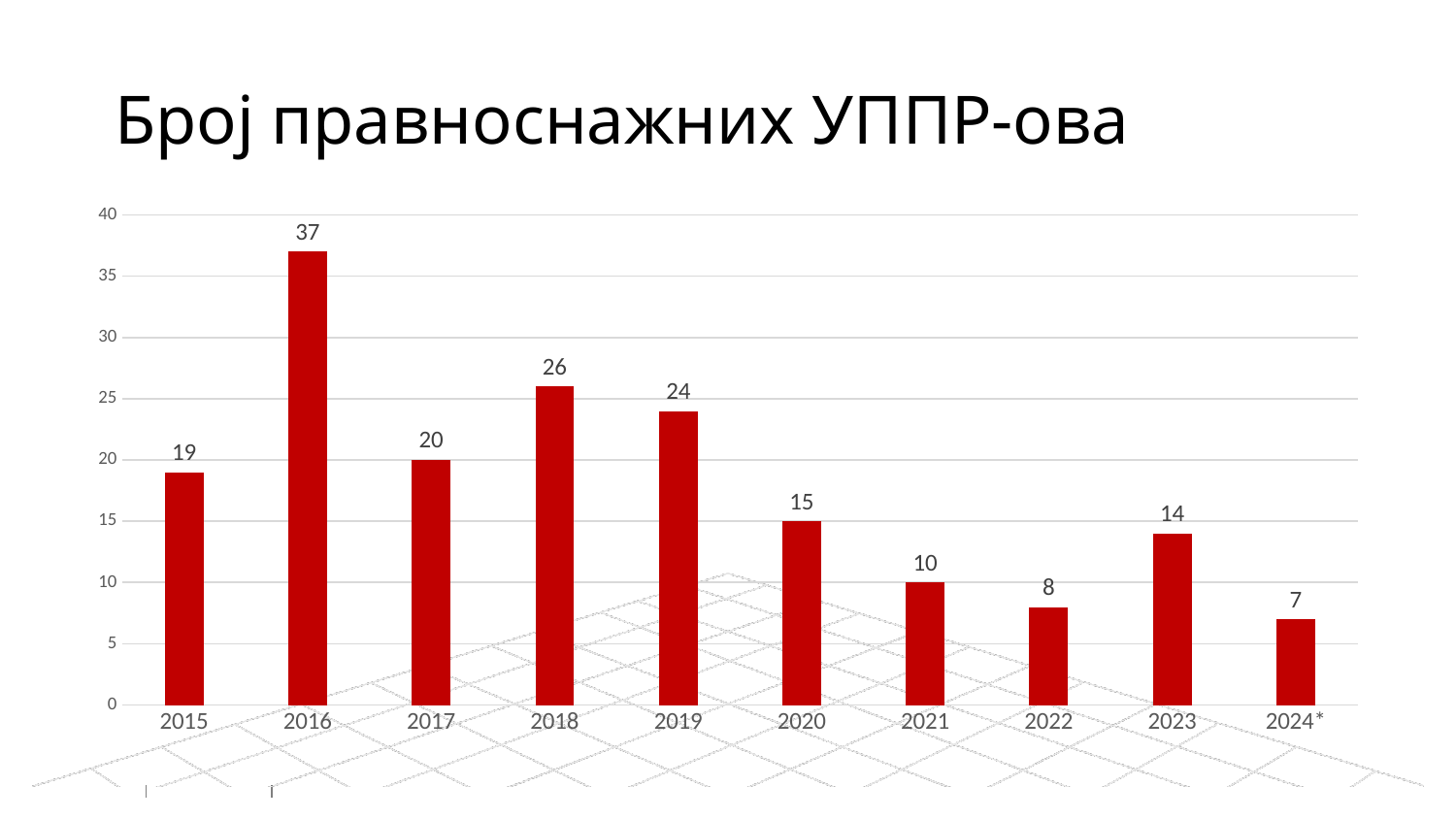
How many years are shown on the x axis? 10 What is the title of the chart? Број правноснажних УППР-ова What is the difference between the values for 2016 and 2017? 17 What kind of chart is this? bar chart Which year has the lowest value? 2024* Which is larger, the value for 2015 or the value for 2020? 2015 Is the value for 2018 greater or less than 25? greater What is the difference between the values for 2018 and 2022? 18 What is the value for 2024*? 7 What is the value for 2016? 37 Which year has the highest value? 2016 What is the value for 2019? 24